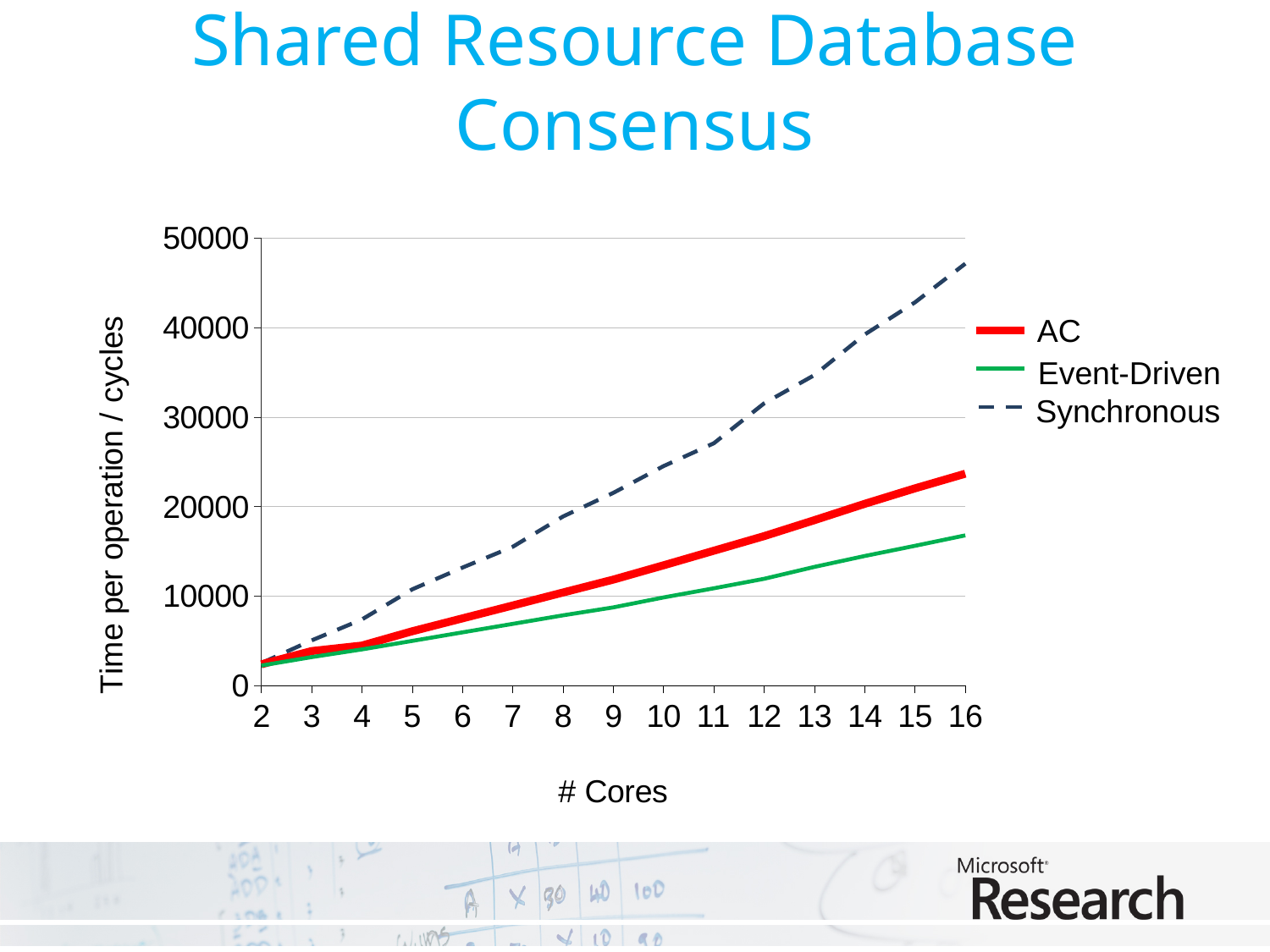
Is the value for Event-Driven at 16 cores greater or less than 20000? less At 16 cores, which is larger: the value for AC or the value for Event-Driven? AC What is the label of the y axis? Time per operation / cycles How many core counts are plotted along the x axis? 15 How many series does the legend list? 3 At 12 cores, which is larger: the value for Synchronous or the value for AC? Synchronous Which series has the lowest time per operation at 16 cores? Event-Driven What kind of chart is shown on the slide? line chart Is the value for AC at 16 cores greater or less than 20000? greater Is the value for Synchronous at 16 cores greater or less than 40000? greater Which series has the highest time per operation at 16 cores? Synchronous Does the time per operation for Synchronous rise or fall as the number of cores increases? rise